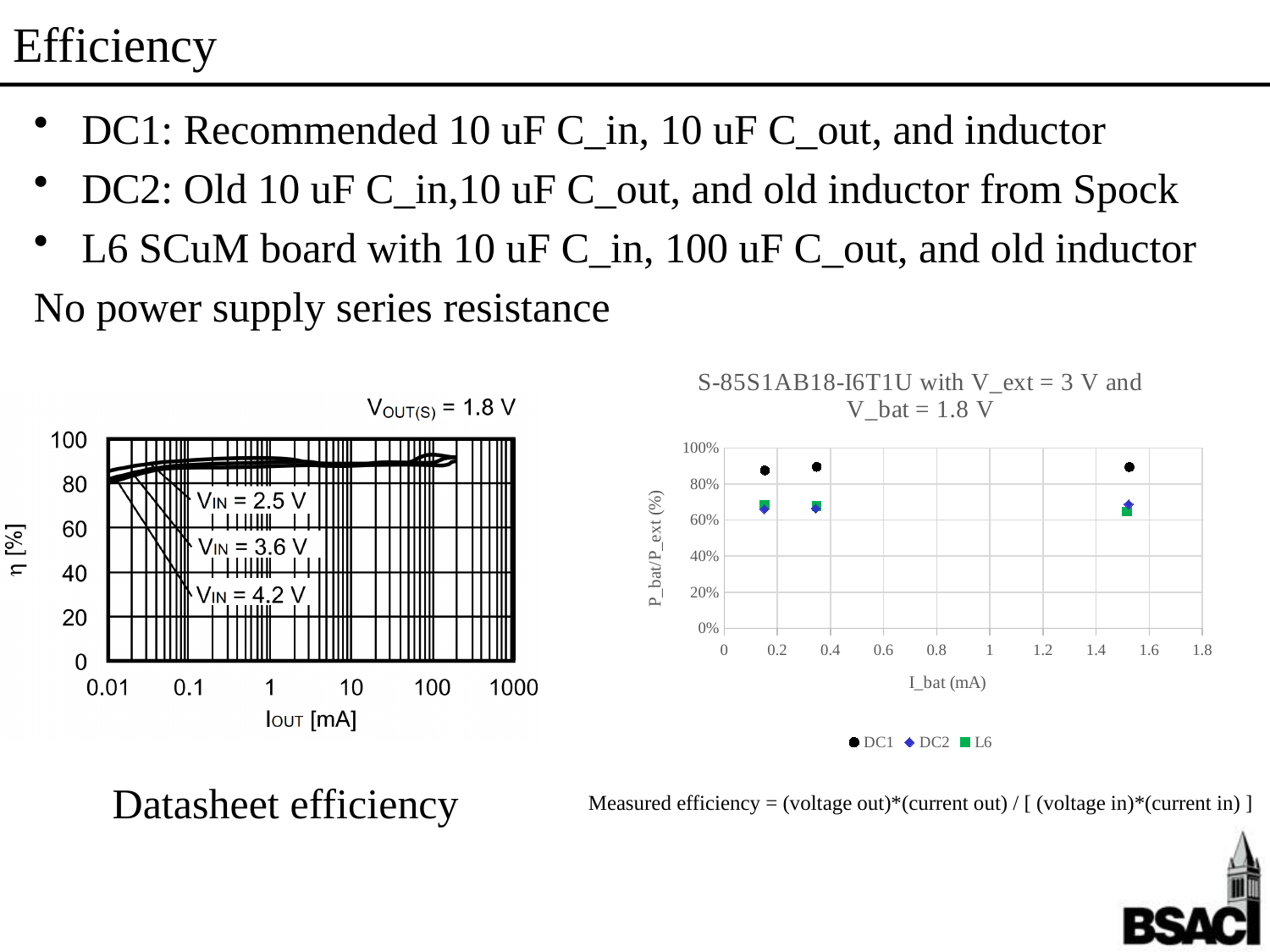
In the right-hand chart (S-85S1AB18-I6T1U), how many series does the legend list? 3 In the right-hand chart (S-85S1AB18-I6T1U), are the DC2 efficiency values greater or less than 80%? less In the right-hand chart (S-85S1AB18-I6T1U), what are the names of the series in the legend? DC1, DC2, L6 What kind of chart is the left-hand 'Datasheet efficiency' chart? line chart What kind of chart is the right-hand chart (S-85S1AB18-I6T1U)? scatter chart In the right-hand chart (S-85S1AB18-I6T1U), how many data points are plotted for the DC1 series? 3 In the right-hand chart (S-85S1AB18-I6T1U), are the L6 efficiency values greater or less than 60%? greater In the right-hand chart (S-85S1AB18-I6T1U), which series has the highest efficiency values? DC1 In the right-hand chart (S-85S1AB18-I6T1U), which series has higher efficiency at I_bat of about 1.5 mA, DC1 or L6? DC1 In the right-hand chart (S-85S1AB18-I6T1U), are the DC1 efficiency values greater or less than 80%? greater In the right-hand chart (S-85S1AB18-I6T1U), what is the label of the x axis? I_bat (mA) In the left-hand 'Datasheet efficiency' chart, how many V_IN curves are plotted? 3